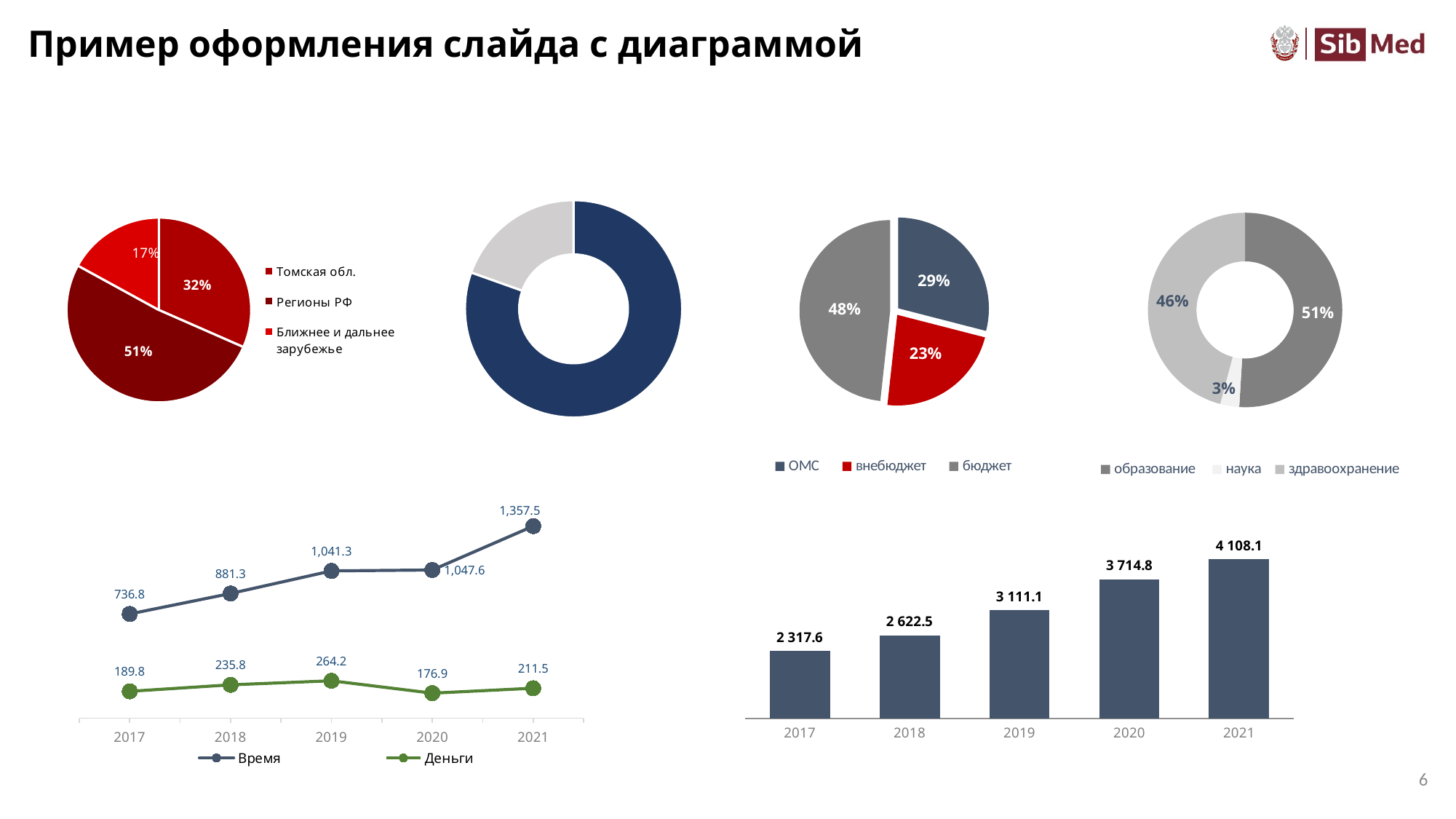
In the line chart at the bottom left, in which year is Деньги highest? 2019 In the bar chart at the bottom right, do the values rise or fall from 2017 to 2021? rise In the line chart at the bottom left, how many series does the legend list? 2 In the bar chart at the bottom right, what is the value for 2021? 4 108.1 In the pie chart with the legend ОМС, внебюджет, бюджет, what share does бюджет have? 48% In the line chart at the bottom left, what is the value of Время in 2019? 1,041.3 What kind of chart is shown at the bottom right of the slide? bar chart In the line chart at the bottom left, which is larger: Деньги in 2018 or Деньги in 2020? Деньги in 2018 In the pie chart with the legend ОМС, внебюджет, бюджет, which category has the smallest share? внебюджет In the donut chart with the legend образование, наука, здравоохранение, what share does наука have? 3% In the bar chart at the bottom right, what is the difference between the values for 2020 and 2019? 603.7 In the bar chart at the bottom right, which year has the lowest value? 2017